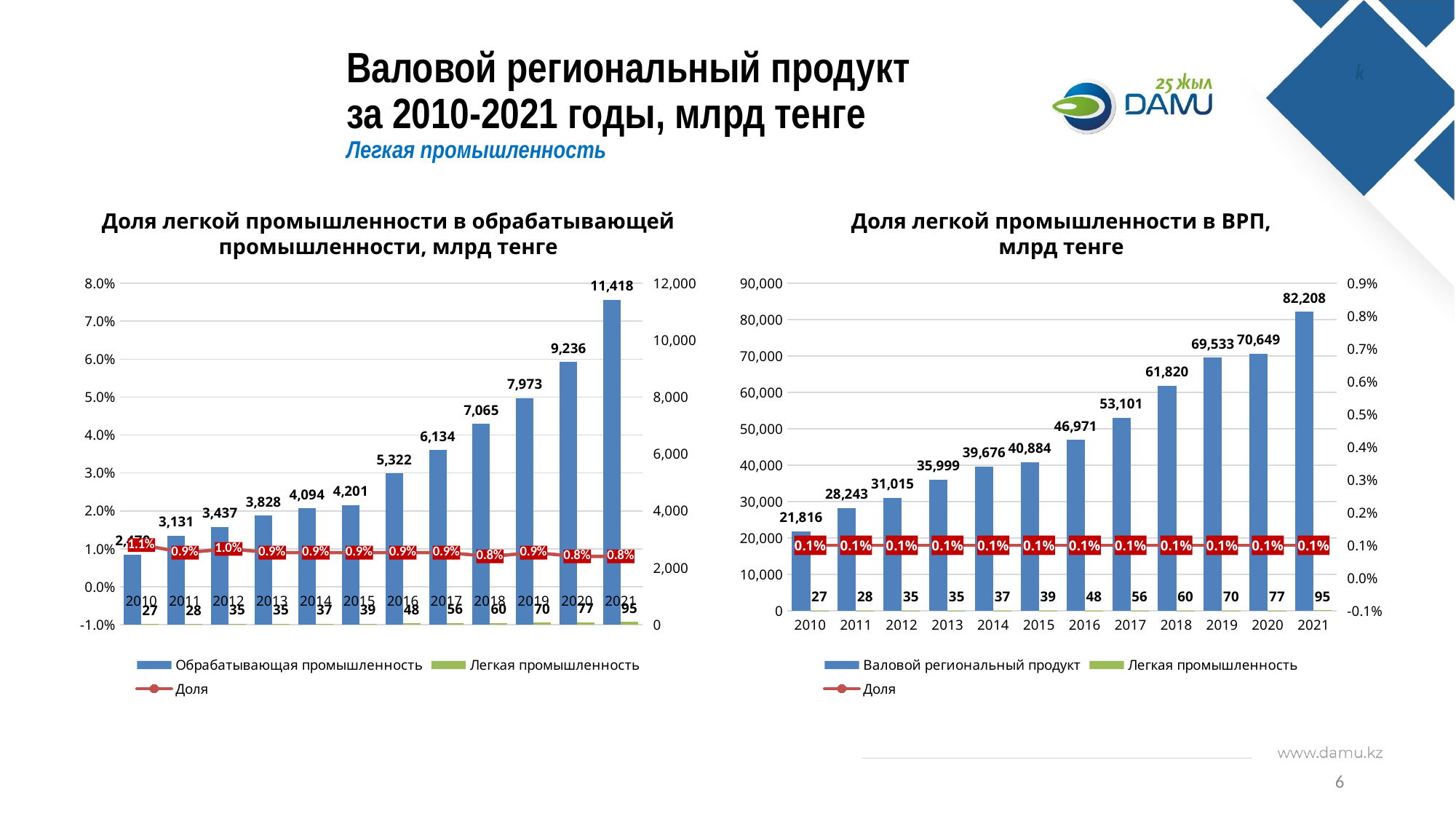
In the chart 'Доля легкой промышленности в обрабатывающей промышленности, млрд тенге', which year has the highest Обрабатывающая промышленность value? 2021 In the chart 'Доля легкой промышленности в обрабатывающей промышленности, млрд тенге', what is the difference between the Обрабатывающая промышленность values for 2020 and 2019? 1,263 In the chart 'Доля легкой промышленности в ВРП, млрд тенге', is the Валовой региональный продукт value for 2018 larger than the value for 2017? Yes, 2018 How many series does the legend of the chart 'Доля легкой промышленности в ВРП, млрд тенге' list? 3 In the chart 'Доля легкой промышленности в обрабатывающей промышленности, млрд тенге', what is the Доля value for 2012? 1.0% In the chart 'Доля легкой промышленности в ВРП, млрд тенге', do the Валовой региональный продукт values rise or fall from 2010 to 2021? Rise In the chart 'Доля легкой промышленности в ВРП, млрд тенге', which year has the lowest Валовой региональный продукт value? 2010 In the chart 'Доля легкой промышленности в ВРП, млрд тенге', what is the value of Легкая промышленность for 2019? 70 In the chart 'Доля легкой промышленности в обрабатывающей промышленности, млрд тенге', what is the value of Обрабатывающая промышленность for 2017? 6,134 How many years are shown on the x axis of the chart 'Доля легкой промышленности в обрабатывающей промышленности, млрд тенге'? 12 In the chart 'Доля легкой промышленности в ВРП, млрд тенге', what is the difference between the Валовой региональный продукт values for 2021 and 2020? 11,559 In the chart 'Доля легкой промышленности в ВРП, млрд тенге', what is the value of Валовой региональный продукт for 2021? 82,208